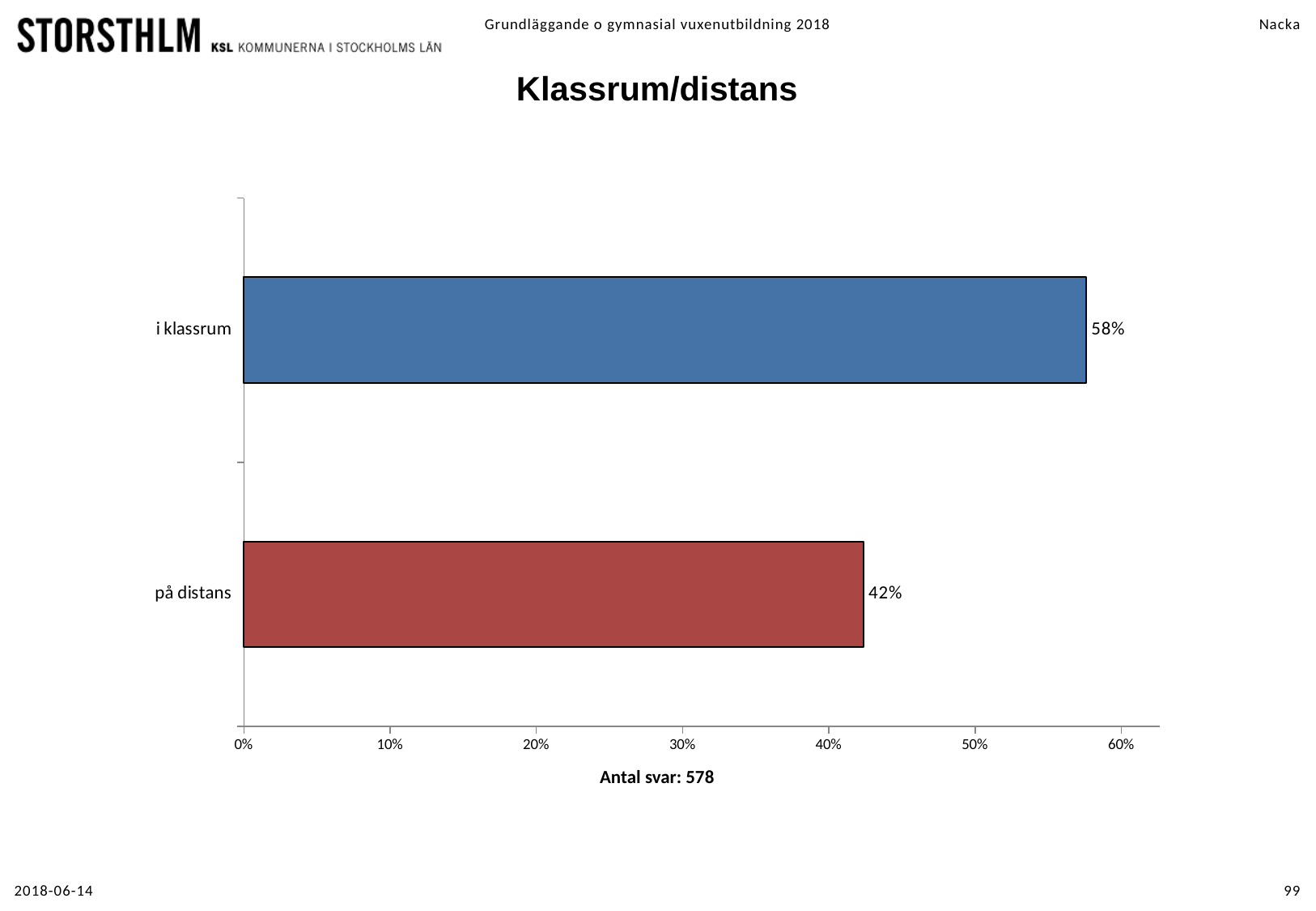
Which is larger, the value for 'i klassrum' or 'på distans'? i klassrum What is the value for 'i klassrum'? 58% What is the number of responses (Antal svar) shown below the chart? 578 Which category has the highest value? i klassrum What is the difference between the values for 'i klassrum' and 'på distans'? 16% What is the title of the chart? Klassrum/distans What is the value for 'på distans'? 42% How many categories are shown in the chart? 2 Which category has the lowest value? på distans Is the value for 'i klassrum' greater or less than 50%? greater Is the value for 'på distans' greater or less than 50%? less What kind of chart is shown on the slide? bar chart